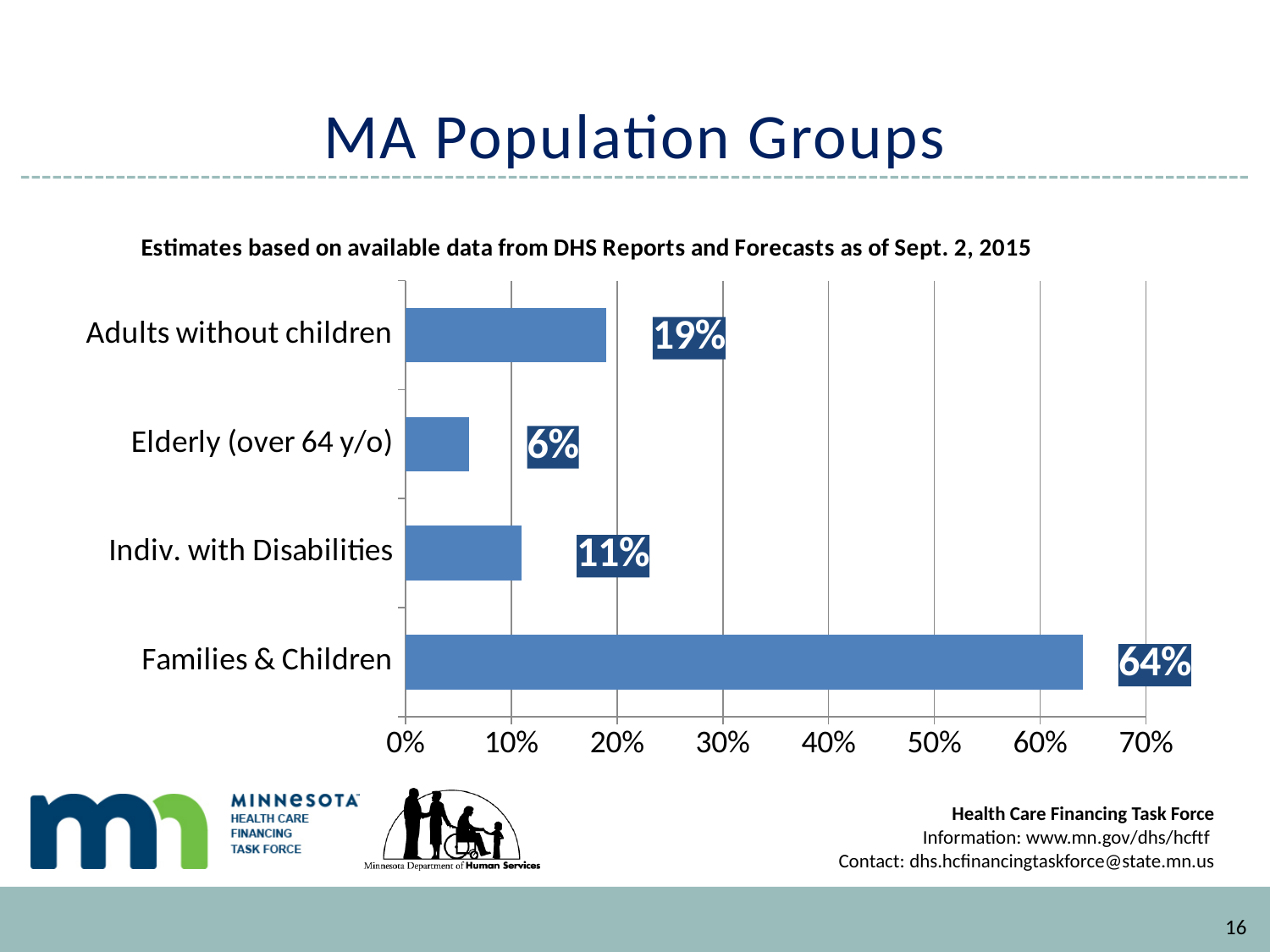
What is the difference between the values for Indiv. with Disabilities and Elderly (over 64 y/o)? 5% What is the value for Indiv. with Disabilities? 11% What is the value for Adults without children? 19% Which population group has the highest value? Families & Children What is the value for Families & Children? 64% Which population group has the lowest value? Elderly (over 64 y/o) What kind of chart is shown on the slide? bar chart What is the difference between the values for Families & Children and Adults without children? 45% Which is larger, the value for Adults without children or the value for Indiv. with Disabilities? Adults without children How many population groups are shown in the chart? 4 Is the value for Families & Children greater or less than 60%? greater What is the value for Elderly (over 64 y/o)? 6%